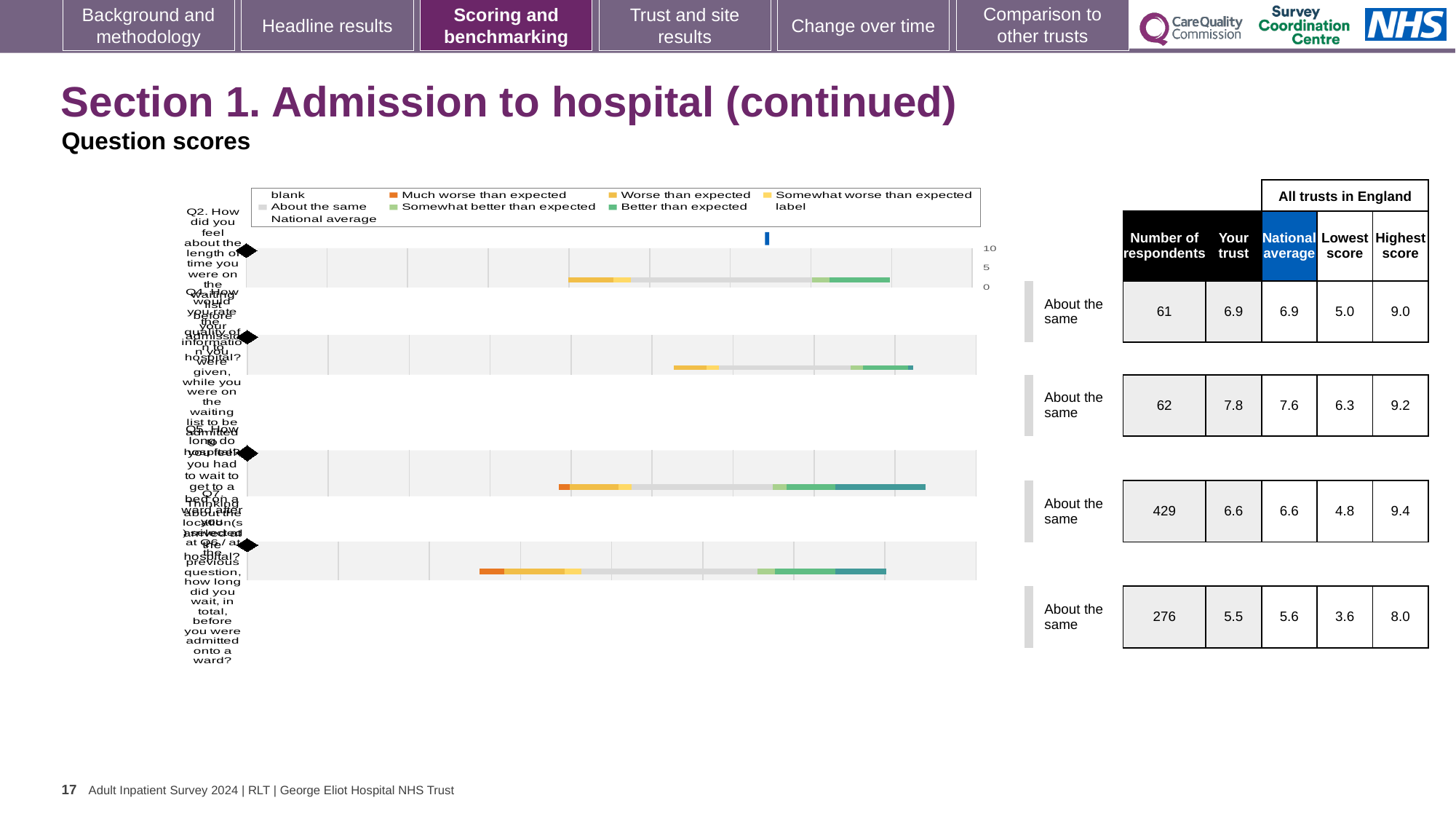
How many entries does the chart legend list? 9 In the table next to the chart, what is the 'Your trust' score for the second question? 7.8 What kind of chart is shown on the slide? bar chart Which question row has the lowest 'Your trust' score? the fourth row (5.5) For the second question, which is larger: the 'Your trust' score or the national average? Your trust What benchmark category is shown for all four questions in the chart? About the same How many questions (rows) are plotted in the chart? 4 In the table next to the chart, what is the number of respondents for the first (top) question? 61 In the table next to the chart, what is the highest score for the fourth (bottom) question? 8.0 Which question row has the highest number of respondents? the third row (429) For the first question, what is the difference between the highest score and the lowest score? 4.0 In the table next to the chart, what is the national average for the third question? 6.6